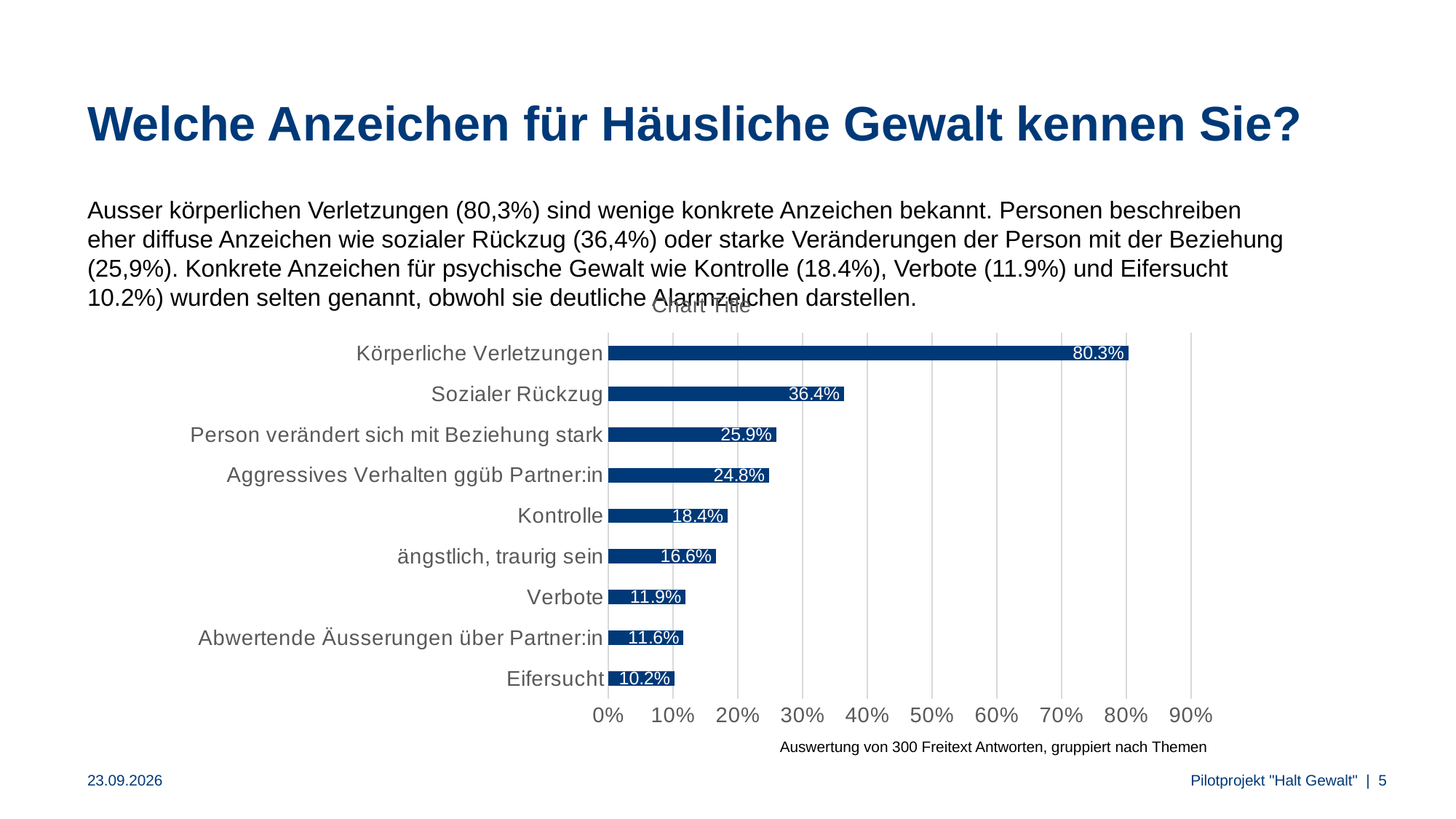
What is the value for Körperliche Verletzungen? 80.3% What is the difference between the values for Körperliche Verletzungen and Sozialer Rückzug? 43.9% Which category has the lowest value? Eifersucht What is the value for Abwertende Äusserungen über Partner:in? 11.6% Which is larger, the value for Sozialer Rückzug or the value for Person verändert sich mit Beziehung stark? Sozialer Rückzug What kind of chart is shown on the slide? Bar chart What is the value for Sozialer Rückzug? 36.4% What is the difference between the values for Kontrolle and Verbote? 6.5% What is the value for Kontrolle? 18.4% How many categories are shown in the chart? 9 What is the highest tick label shown on the horizontal axis? 90% Which category has the highest value? Körperliche Verletzungen